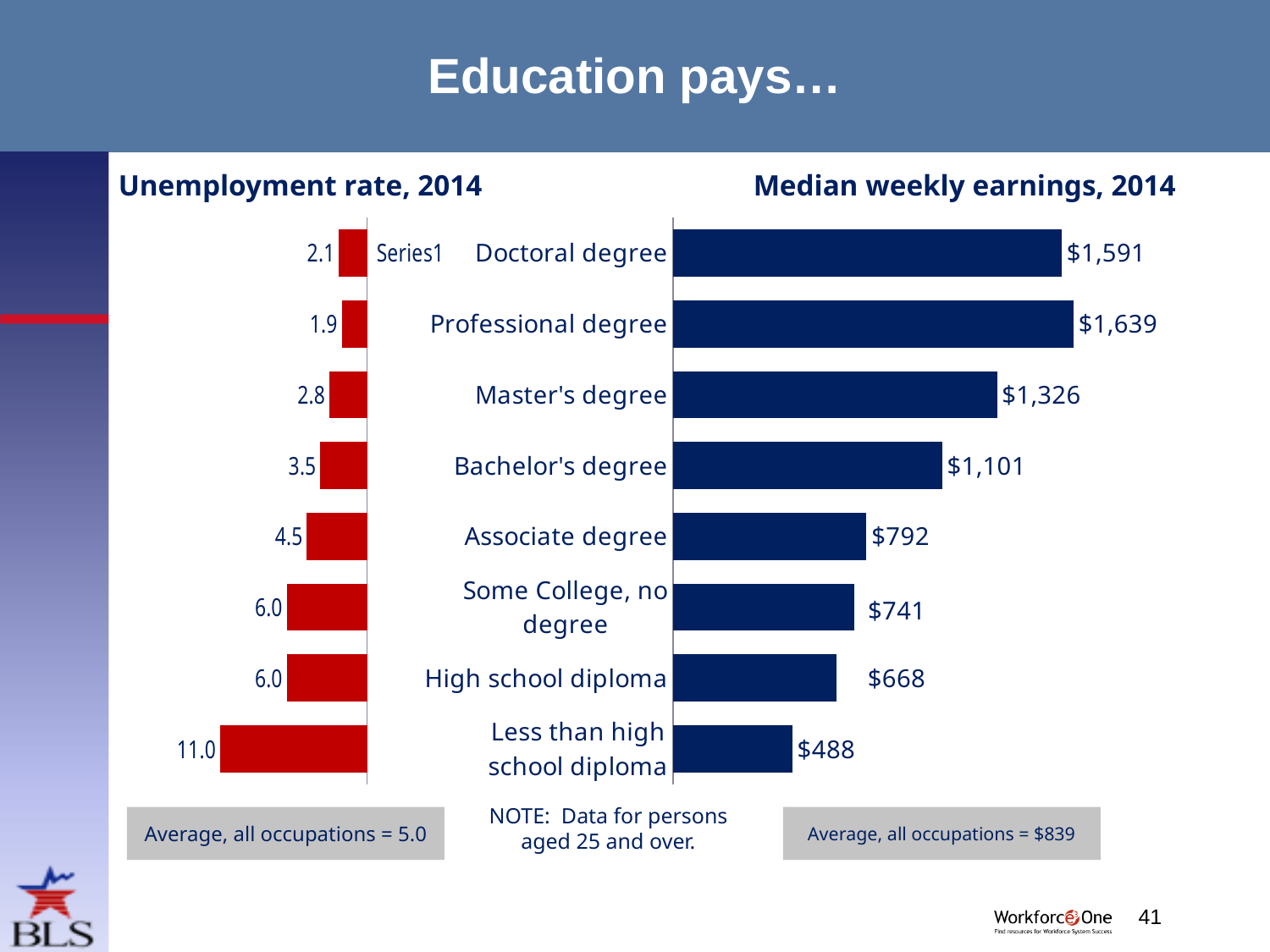
In the Median weekly earnings, 2014 chart, which category has the lowest median weekly earnings? Less than high school diploma In the Unemployment rate, 2014 chart, what is the difference between the unemployment rate for Less than high school diploma and for Associate degree? 6.5 What colour are the bars in the Median weekly earnings, 2014 chart? Dark blue In the Median weekly earnings, 2014 chart, what are the median weekly earnings for Master's degree? $1,326 In the Unemployment rate, 2014 chart, which category has the lowest unemployment rate? Professional degree In the Median weekly earnings, 2014 chart, which category has the highest median weekly earnings? Professional degree In the Unemployment rate, 2014 chart, which category has the highest unemployment rate? Less than high school diploma What type of chart is the Unemployment rate, 2014 chart? Bar chart In the Unemployment rate, 2014 chart, what is the unemployment rate for Bachelor's degree? 3.5 In the Median weekly earnings, 2014 chart, which has higher median weekly earnings, Associate degree or High school diploma? Associate degree In the Median weekly earnings, 2014 chart, what is the difference in median weekly earnings between Doctoral degree and Bachelor's degree? $490 How many education categories are shown in the Median weekly earnings, 2014 chart? 8